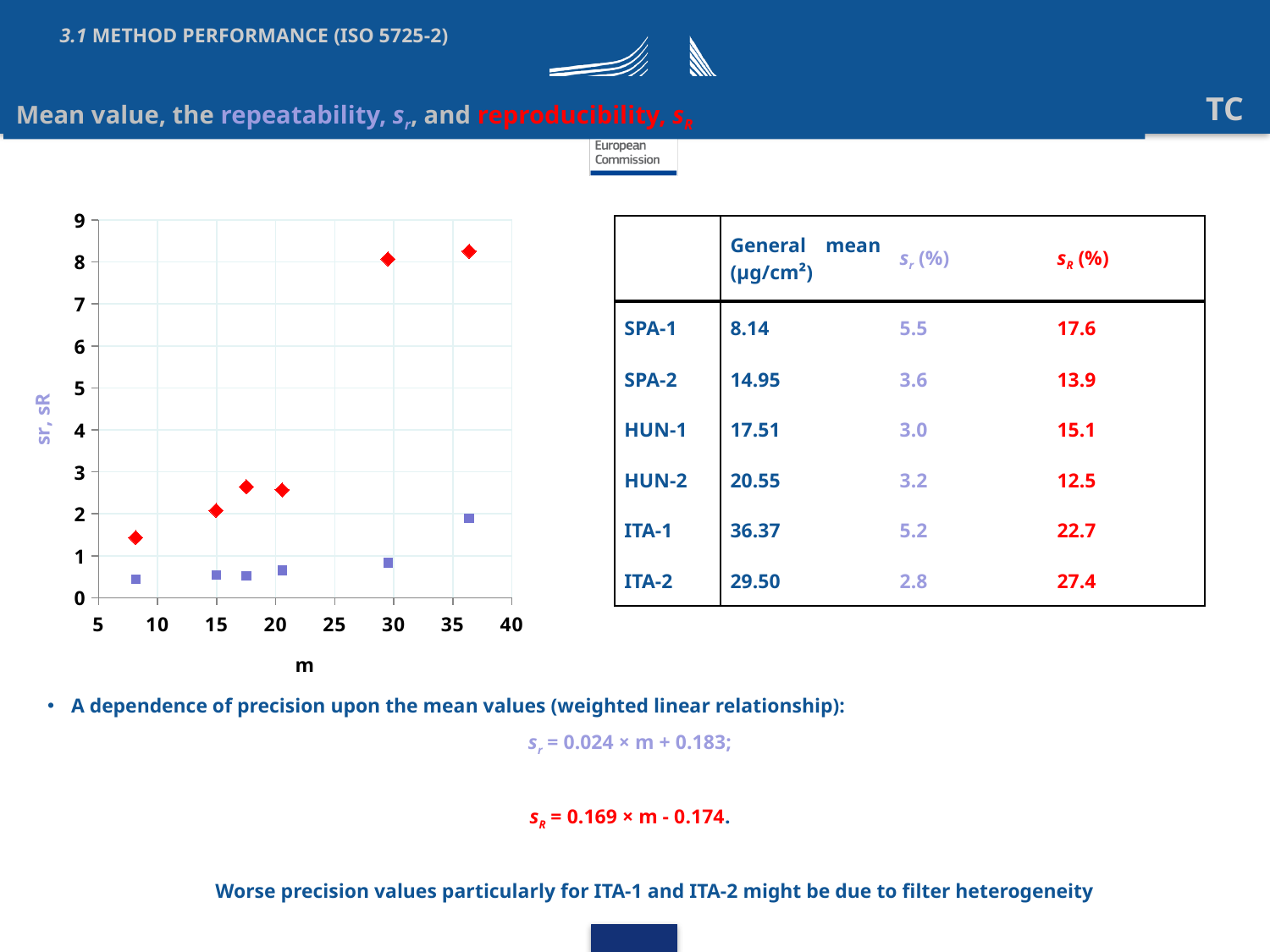
What kind of chart is shown on the slide? scatter chart Is the value of the rightmost blue square point greater or less than 3? less At the largest m value, which is higher: the red diamond point or the blue square point? the red diamond point How many red diamond points are plotted on the chart? 6 What is the label of the y axis of the chart? sr, sR Is the value of the leftmost blue square point greater or less than 1? less Is the value of the rightmost red diamond point greater or less than 7? greater What is the label of the x axis of the chart? m How many blue square points are plotted on the chart? 6 Do the blue square values generally rise or fall as m increases? rise Which series reaches the highest value on the chart, the red diamonds or the blue squares? the red diamonds